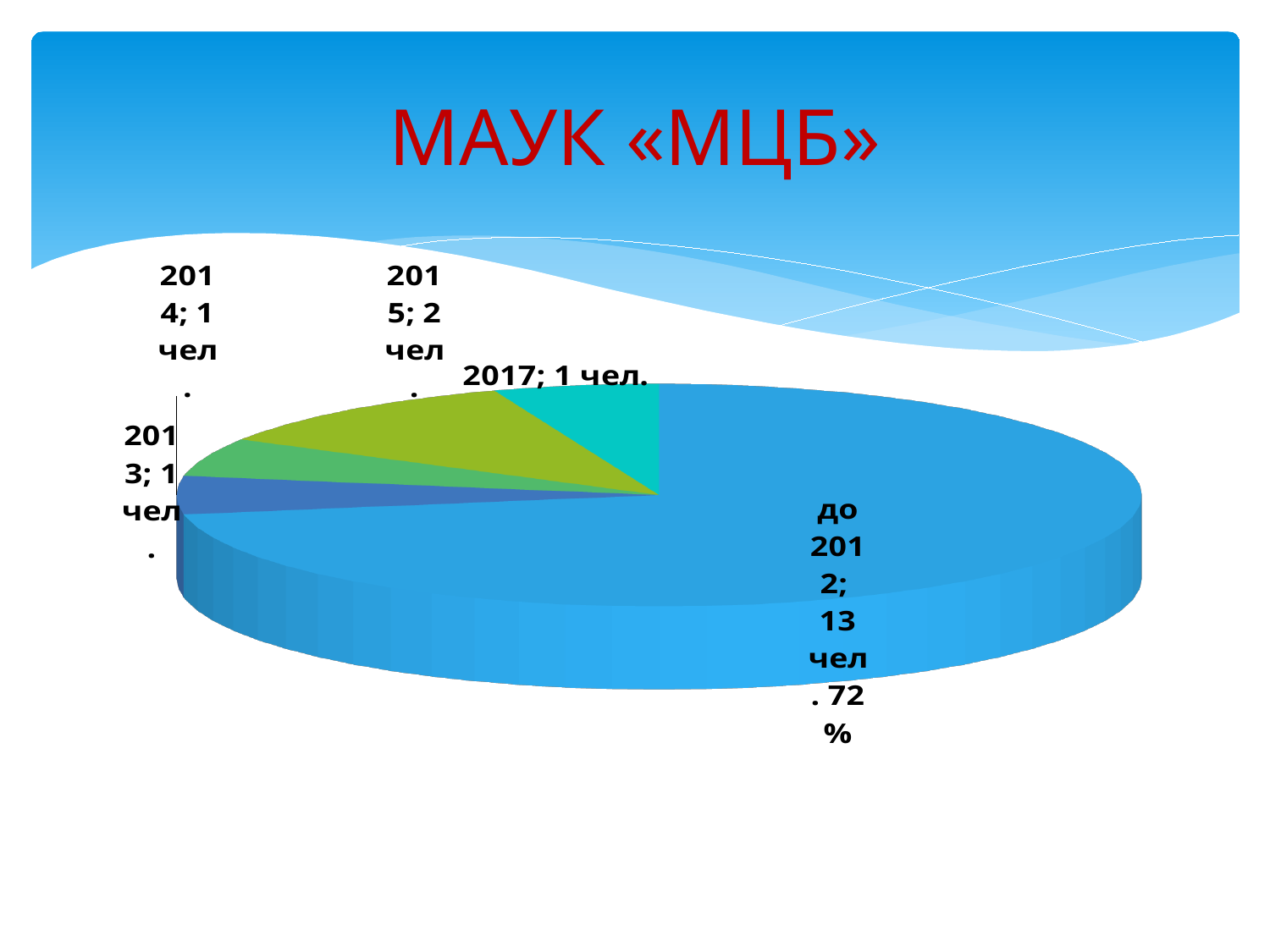
How many people are in the "2015" slice? 2 чел. Which category has the largest slice of the pie? до 2012 What is the difference in people between the "до 2012" slice and the "2015" slice? 11 What kind of chart is shown on the slide? pie chart How many people are in the "2017" slice? 1 чел. How many slices does the pie chart have? 5 What is the title of the slide containing the pie chart? МАУК «МЦБ» How many people are in the "до 2012" slice? 13 чел. What is the total number of people across all slices of the pie? 18 What share of the pie does the "до 2012" slice represent? 72% Which slice is larger, "2015" or "2014"? 2015 How many people are in the "2013" slice? 1 чел.